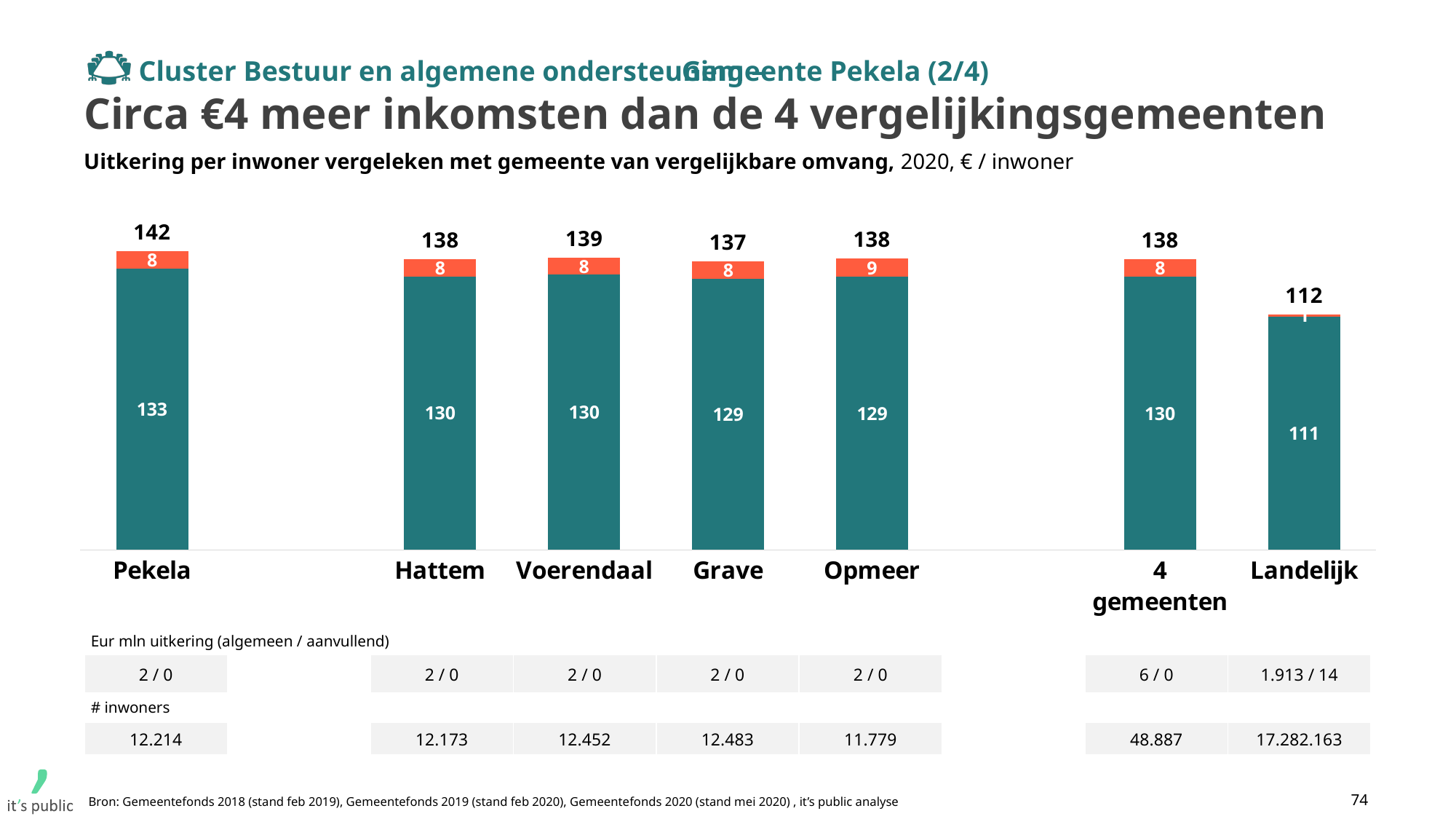
Which category has the lowest total value? Landelijk How many categories are shown on the x axis of the chart? 7 Which has a larger total value, Voerendaal or Grave? Voerendaal What is the total value shown above the bar for Pekela? 142 What is the value of the orange (upper) segment for Opmeer? 9 What is the difference between the total for Pekela and the total for 4 gemeenten? 4 Which category has the highest total value? Pekela What kind of chart is shown on the slide? Stacked bar chart What is the value of the teal (lower) segment for Landelijk? 111 What is the value of the teal (lower) segment for Hattem? 130 What is the total value shown above the bar for Landelijk? 112 What is the difference between the teal segment for Pekela and the teal segment for Grave? 4